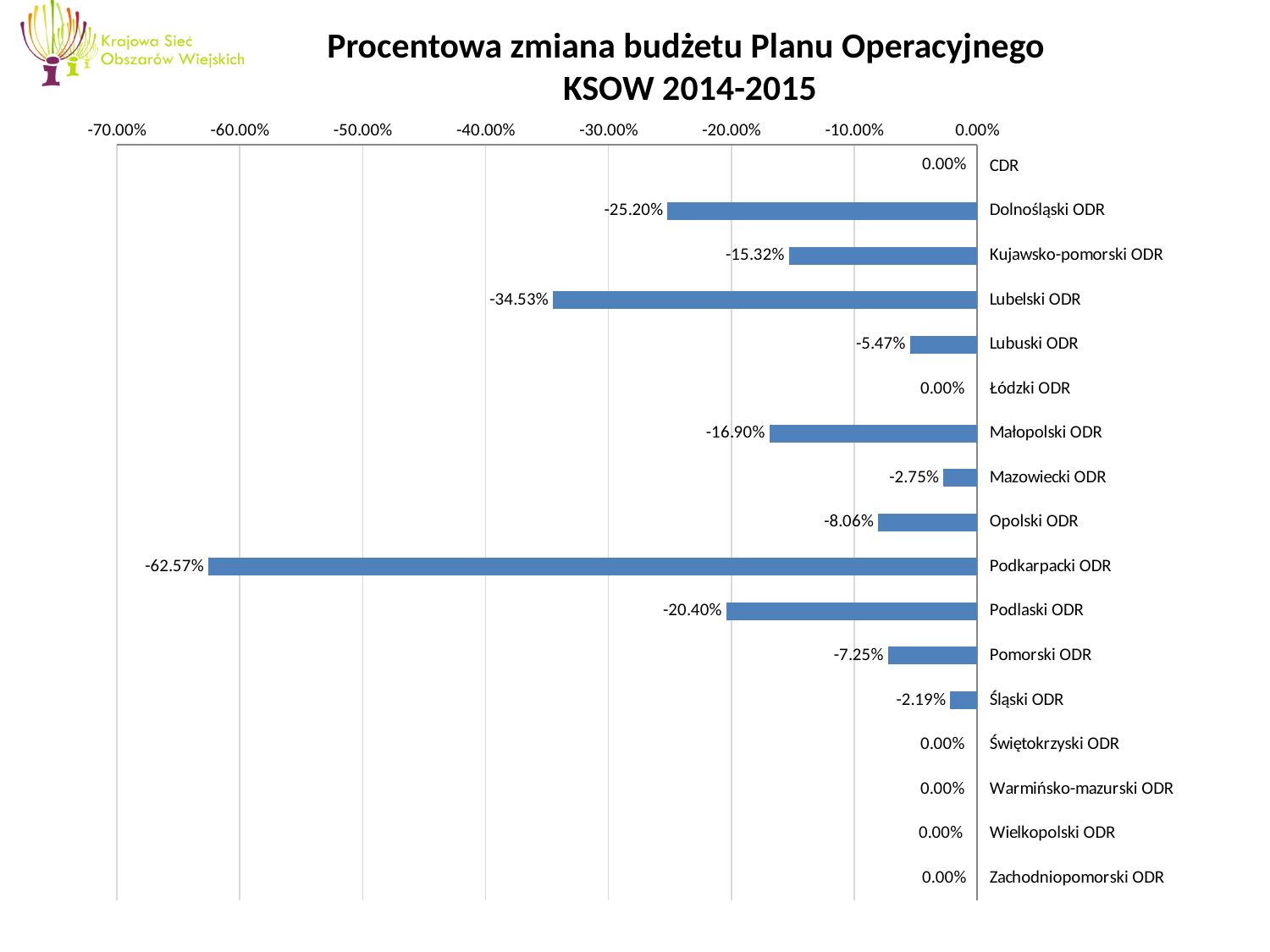
What is the value shown for Mazowiecki ODR? -2.75% What is the value shown for Lubelski ODR? -34.53% What kind of chart is shown on the slide? Bar chart What is the value shown for Podlaski ODR? -20.40% Which has the larger percentage decrease, Małopolski ODR or Kujawsko-pomorski ODR? Małopolski ODR Which category has the largest percentage decrease (the most negative value)? Podkarpacki ODR How many categories show a value of 0.00%? 6 How many categories are shown on the chart? 17 What is the percentage change shown for Podkarpacki ODR? -62.57% What is the title of the chart? Procentowa zmiana budżetu Planu Operacyjnego KSOW 2014-2015 What is the difference between the values for Lubelski ODR and Dolnośląski ODR? 9.33 percentage points What is the value shown for Dolnośląski ODR? -25.20%